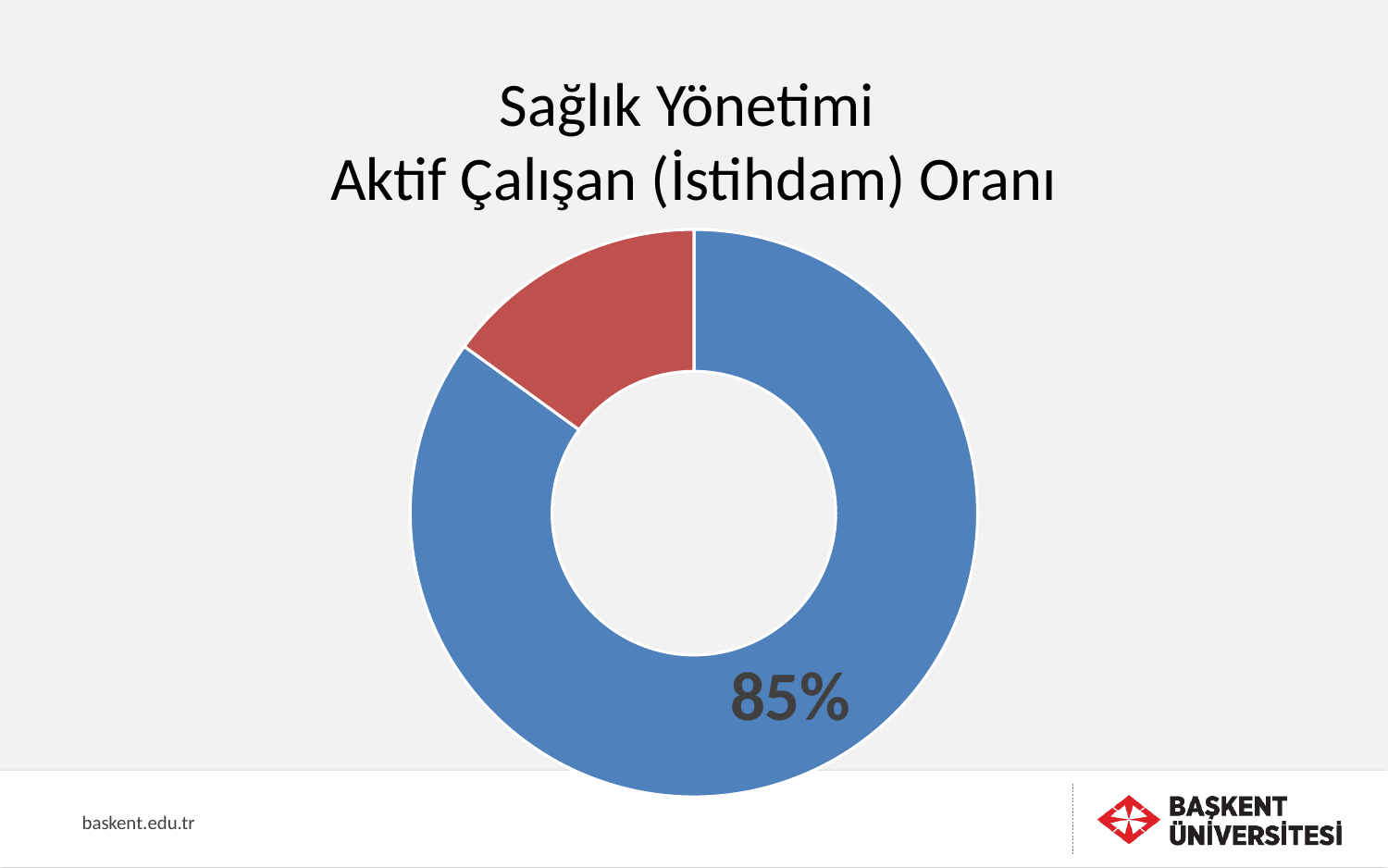
What is the title of the chart? Sağlık Yönetimi Aktif Çalışan (İstihdam) Oranı Which slice of the chart is the smallest? The red slice What colour is the slice labelled 85%? Blue How many slices does the doughnut chart have? 2 What share of the doughnut does the blue slice represent? 85% What percentage is printed on the blue slice of the chart? 85% Which slice is larger, the blue one or the red one? The blue one What kind of chart is shown on the slide? Doughnut (pie) chart Which slice of the chart is the largest? The blue slice (85%)